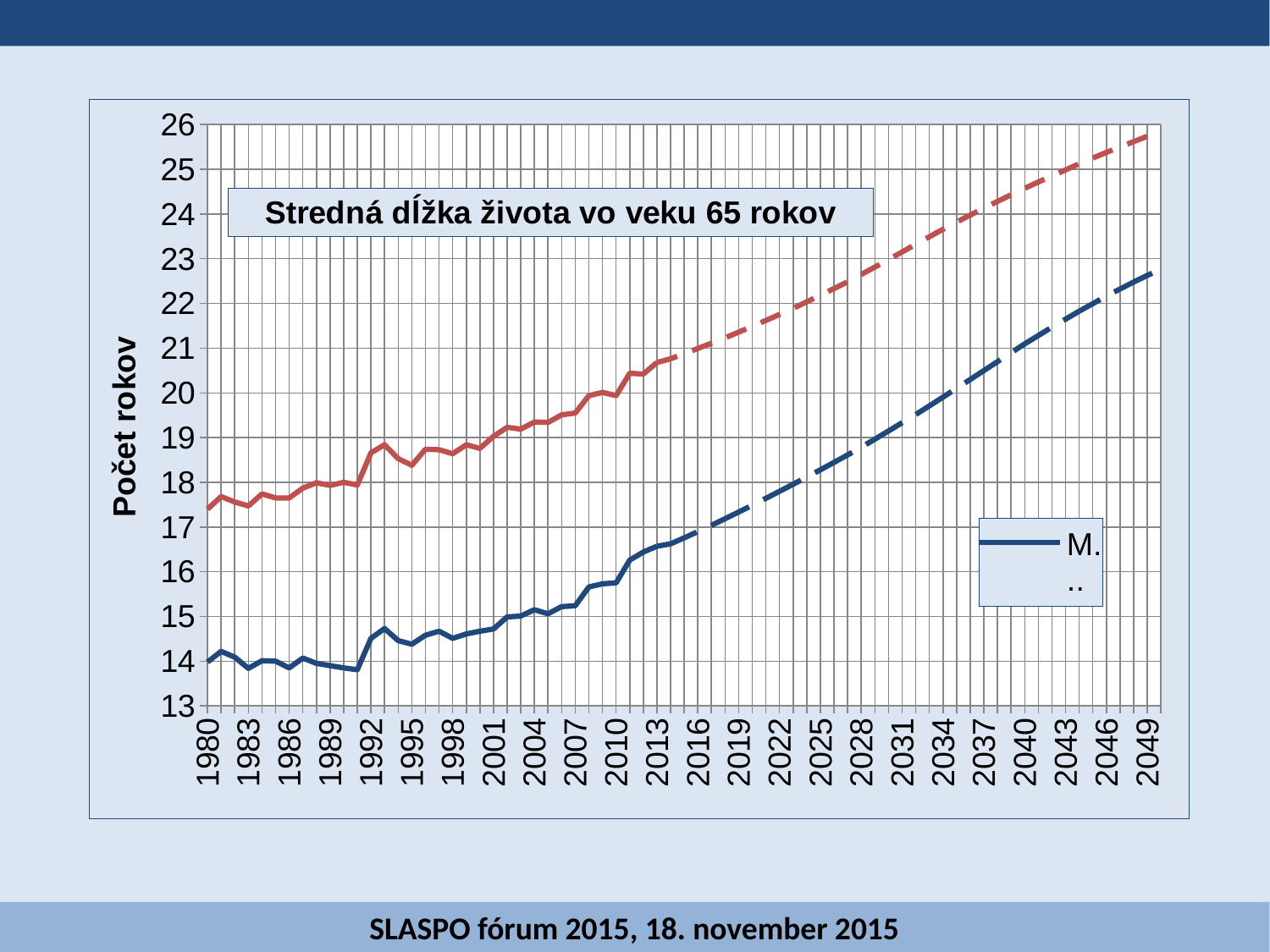
Is the value of the blue line (M.) in 2049 greater or less than 22? greater What is the label of the vertical axis? Počet rokov Do the values of the red line rise or fall from 1980 to 2049? rise Do the values of the blue line (M.) rise or fall from 1980 to 2049? rise What is the title of the chart? Stredná dĺžka života vo veku 65 rokov What kind of chart is shown on the slide? line chart Is the value of the blue line (M.) in 2010 greater or less than 16? less Is the value of the red line in 2049 greater or less than 25? greater Which line is higher in 2049, the blue line or the red line? the red line